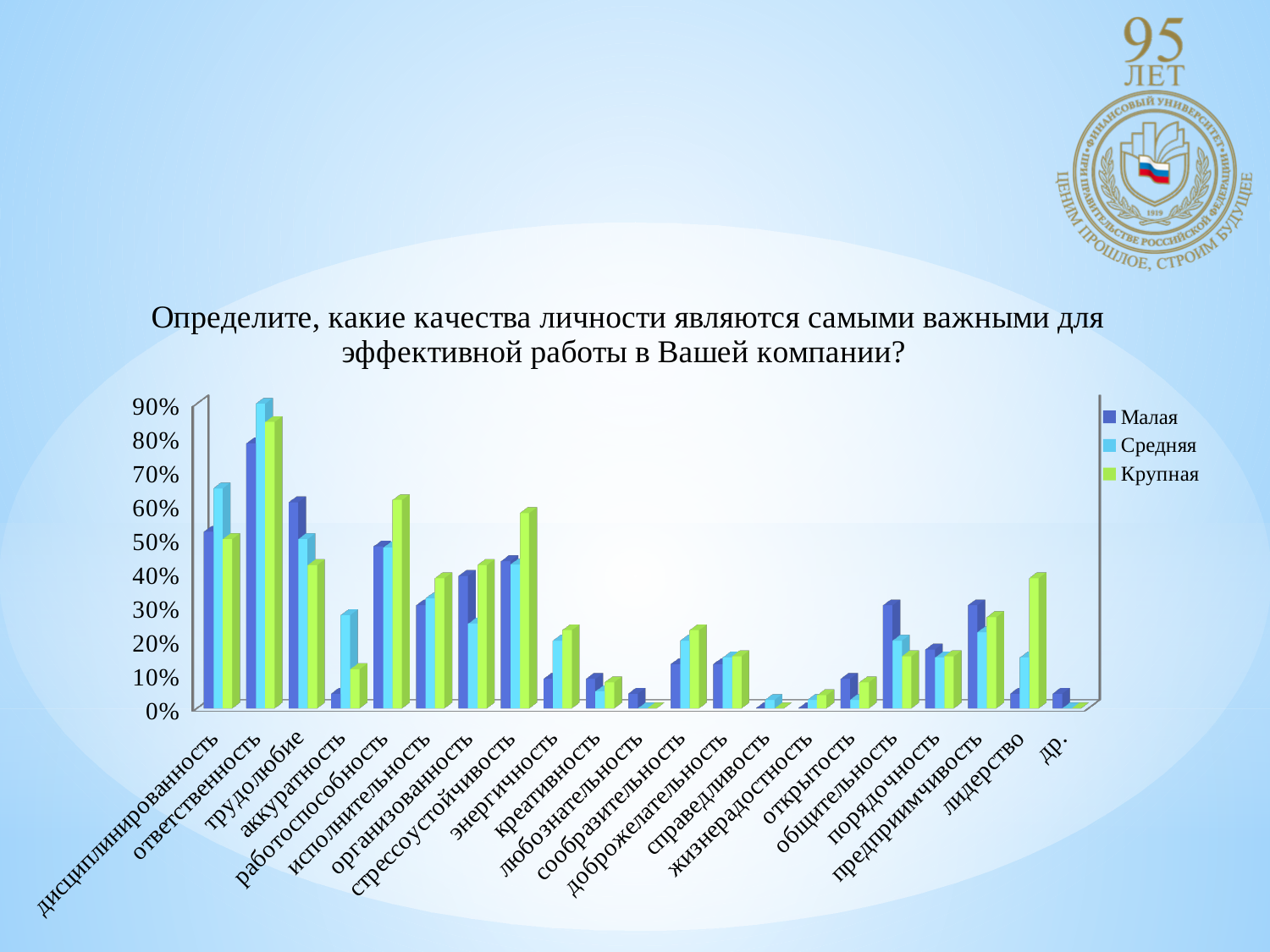
For лидерство, which series has the larger value, Крупная or Малая? Крупная How many series does the legend list? 3 Which category has the highest value for the Средняя series? ответственность What kind of chart is shown on the slide? bar chart Is the Малая value for аккуратность greater or less than 10%? less What are the three series listed in the legend? Малая, Средняя, Крупная How many categories are shown on the x axis? 21 For лидерство, which series has the lowest value? Малая For аккуратность, which series has the larger value, Средняя or Малая? Средняя Is the Крупная value for работоспособность greater or less than 50%? greater Is the Крупная value for лидерство greater or less than 30%? greater